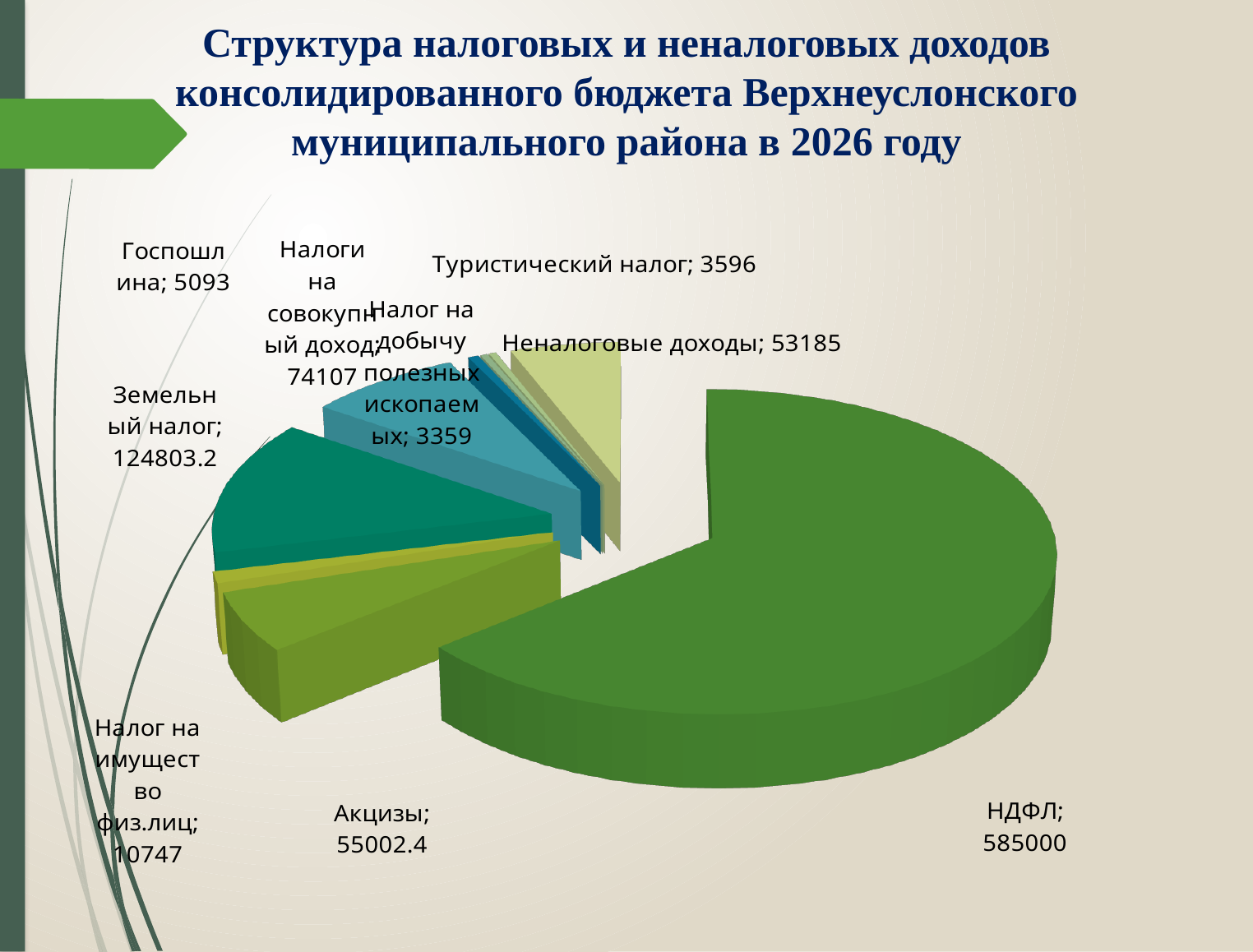
What is the value for Налог на добычу полезных ископаемых? 3359 Which is larger, Акцизы or Неналоговые доходы? Акцизы What is the difference between the values for Госпошлина and Налог на добычу полезных ископаемых? 1734 Which category has the largest value? НДФЛ What is the value for Акцизы? 55002.4 How many categories are shown in the pie chart? 9 What is the difference between the values for НДФЛ and Земельный налог? 460196.8 Which category has the smallest value? Налог на добычу полезных ископаемых What is the value for НДФЛ? 585000 What is the value for Земельный налог? 124803.2 What is the value for Неналоговые доходы? 53185 What type of chart is shown on the slide? Pie chart